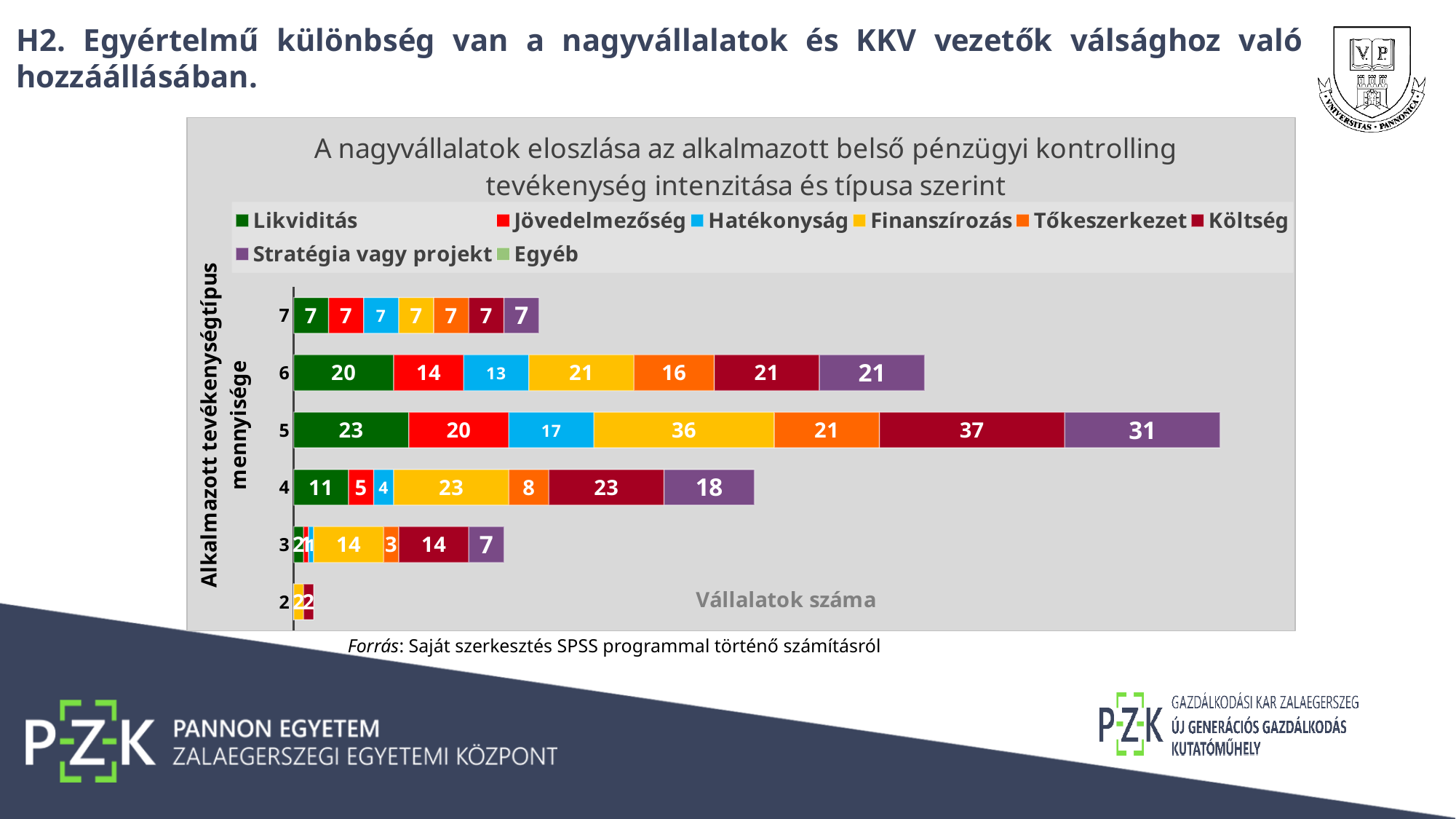
Which is larger: the Finanszírozás value for category 5 or for category 4? Category 5 How many series does the legend list? 8 What is the Költség value for category 5? 37 Which category has the shortest stacked bar overall? 2 How many categories (activity-count levels) are shown on the vertical axis? 6 What is the total of the stacked bar for category 7? 49 What is the Likviditás value for category 4? 11 What is the Stratégia vagy projekt value for category 6? 21 What type of chart is shown on the slide? Stacked bar chart What is the Finanszírozás value for category 5? 36 What is the difference between the Költség value for category 5 and the Költség value for category 4? 14 Which category has the longest stacked bar overall? 5